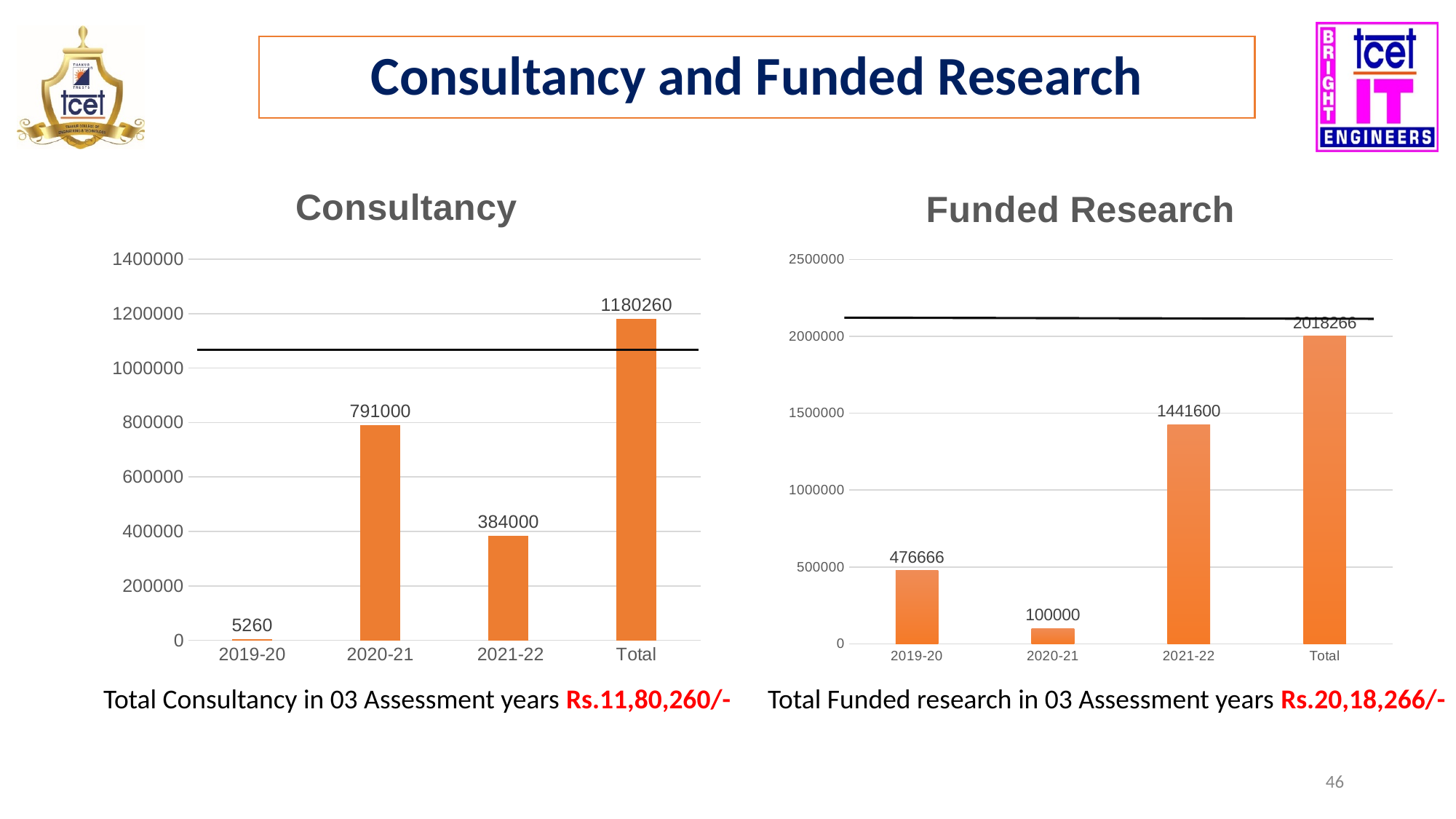
How many bars are plotted in the Consultancy chart? 4 In the Funded Research chart, which category has the lowest value? 2020-21 In the Consultancy chart, what is the difference between the values for 2020-21 and 2021-22? 407000 In the Funded Research chart, what is the difference between the values for 2021-22 and 2019-20? 964934 What type of chart is the Funded Research chart? Bar chart In the Funded Research chart, which is larger: the value for 2019-20 or the value for 2020-21? 2019-20 In the Consultancy chart, what is the value for 2020-21? 791000 In the Consultancy chart, which of the three assessment years has the highest value? 2020-21 In the Consultancy chart, what is the value for 2019-20? 5260 In the Funded Research chart, what is the value for 2020-21? 100000 In the Funded Research chart, what is the value shown for Total? 2018266 In the Funded Research chart, what is the value for 2021-22? 1441600